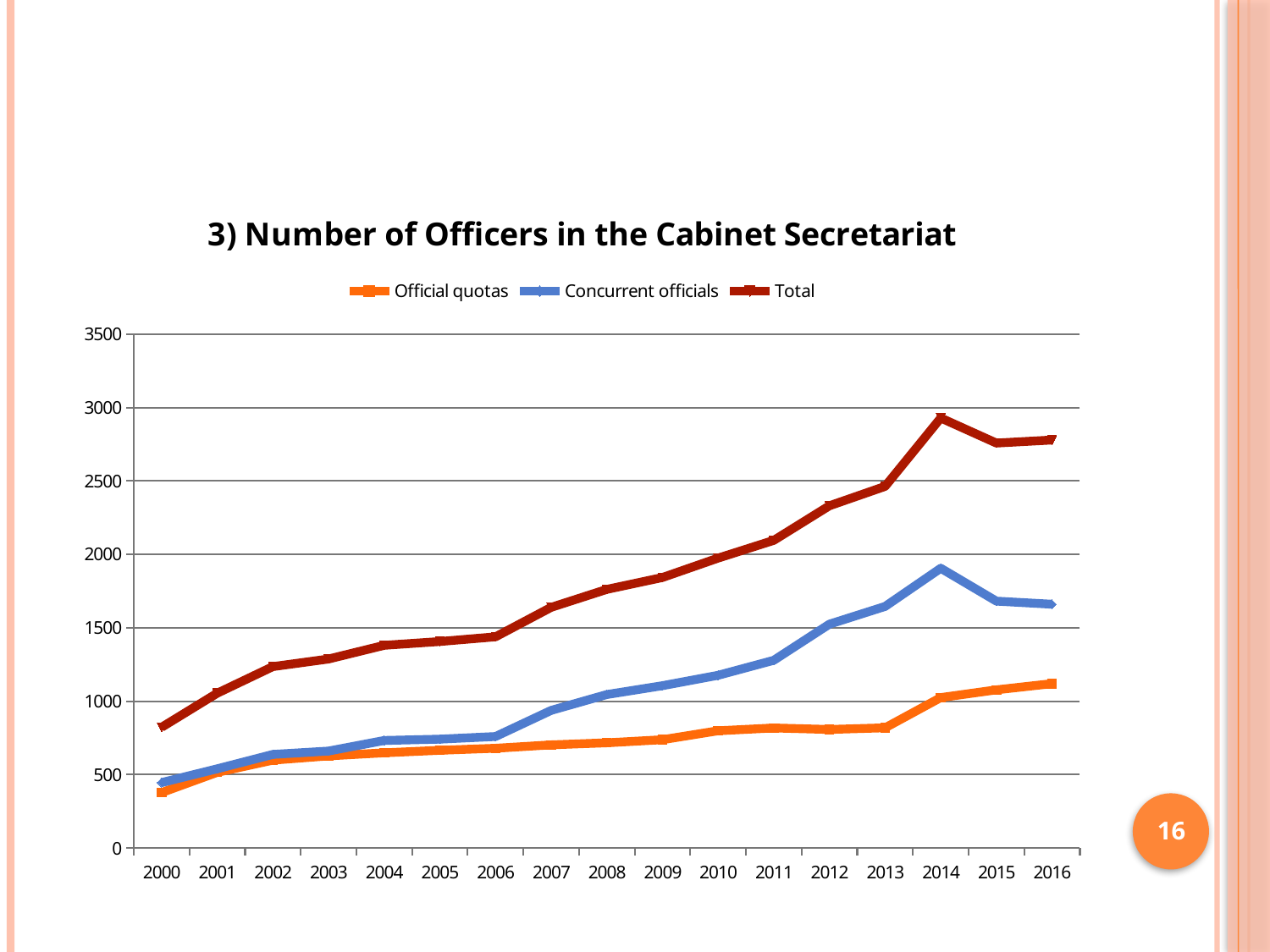
In which year is the Total series at its lowest value? 2000 Is the value for Total in 2000 greater or less than 1000? less Is the value for Official quotas in 2000 greater or less than 500? less Does the Total series generally rise or fall from 2000 to 2014? Rise What kind of chart is shown on the slide? Line chart How many years are plotted along the x axis? 17 Is the value for Concurrent officials in 2016 greater or less than 1500? greater In which year does the Total series reach its highest value? 2014 In 2016, which is larger: Concurrent officials or Official quotas? Concurrent officials How many series does the legend list? 3 In which year does the Concurrent officials series peak? 2014